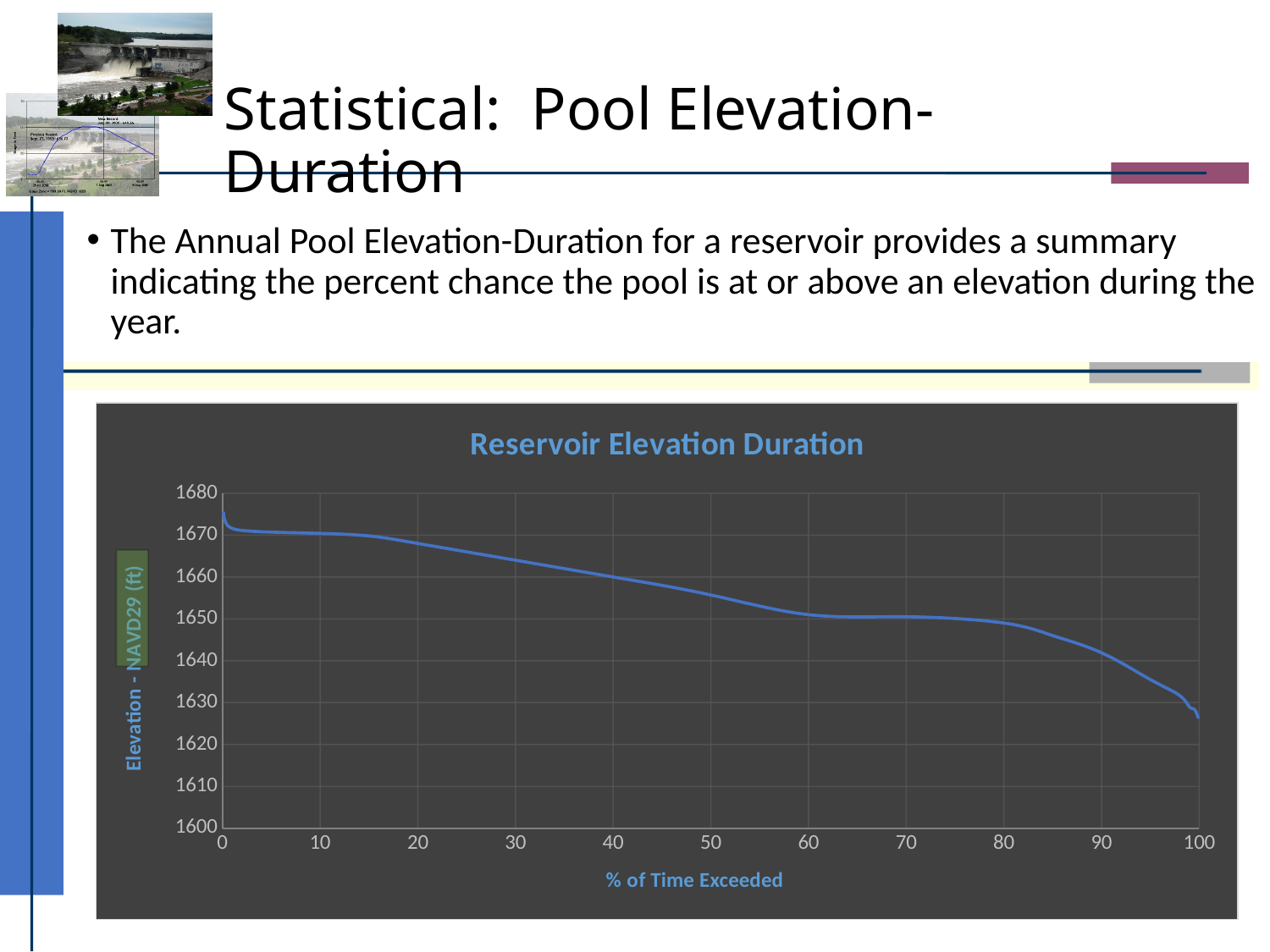
At which % of time exceeded is the elevation highest? 0 What is the label of the x axis of the chart? % of Time Exceeded Is the elevation at 20% of time exceeded greater or less than 1670? less What is the title of the chart? Reservoir Elevation Duration Is the elevation at 30% of time exceeded greater or less than 1660? greater What kind of chart is shown on the slide? line chart At which % of time exceeded is the elevation lowest? 100 Is the elevation at 100% of time exceeded greater or less than 1630? less Is the elevation at 10% of time exceeded larger or smaller than the elevation at 90% of time exceeded? larger Does the elevation rise or fall as the % of time exceeded increases from 0 to 100? fall